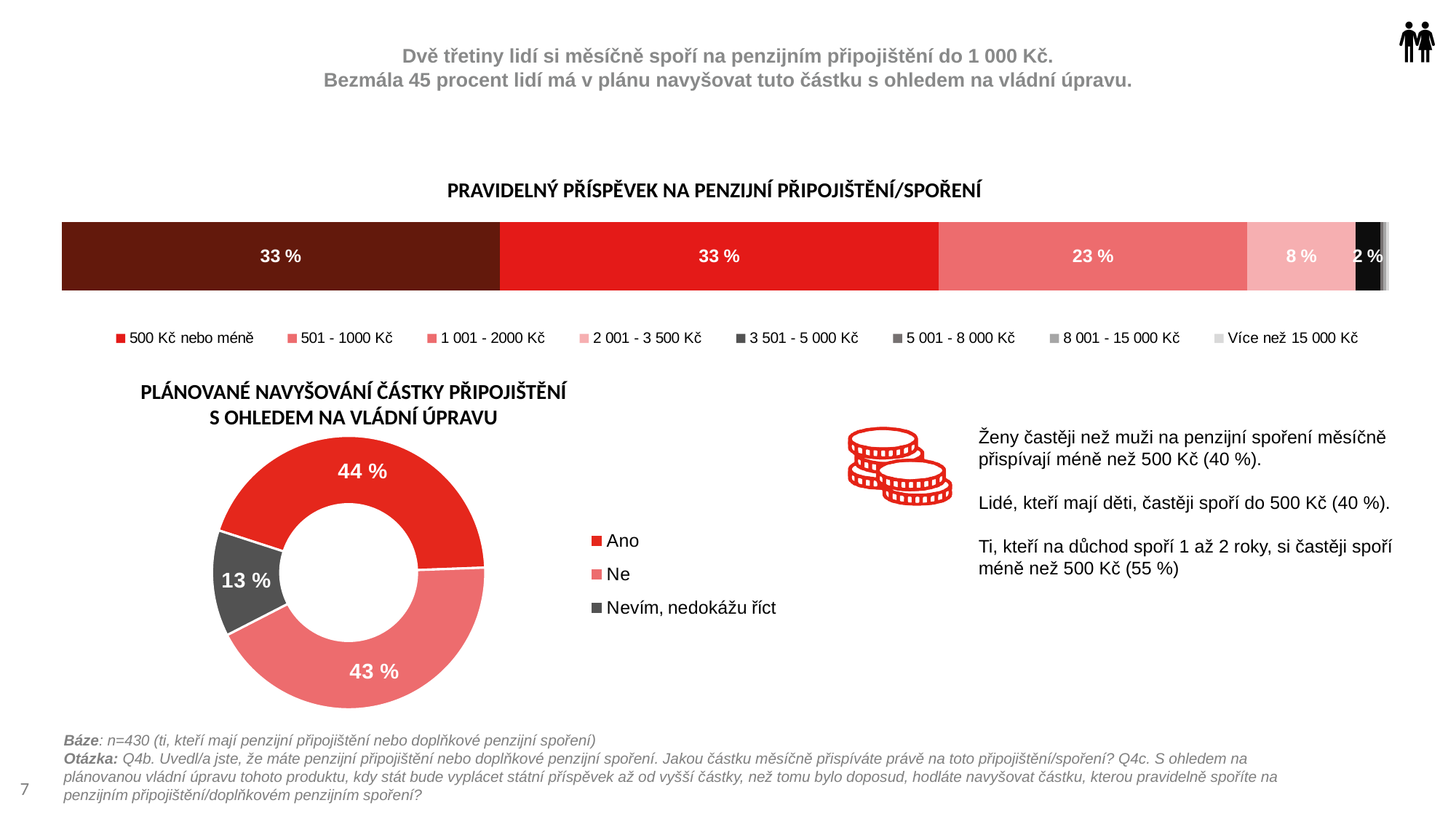
In the chart 'Pravidelný příspěvek na penzijní připojištění/spoření', what is the value for the '2 001 - 3 500 Kč' segment? 8 % In the chart 'Plánované navyšování částky připojištění s ohledem na vládní úpravu', what is the value for 'Nevím, nedokážu říct'? 13 % In the chart 'Pravidelný příspěvek na penzijní připojištění/spoření', how many entries does the legend list? 8 In the chart 'Plánované navyšování částky připojištění s ohledem na vládní úpravu', which category has the lowest value? Nevím, nedokážu říct In the chart 'Pravidelný příspěvek na penzijní připojištění/spoření', what is the difference between the '1 001 - 2000 Kč' segment and the '2 001 - 3 500 Kč' segment? 15 % In the chart 'Plánované navyšování částky připojištění s ohledem na vládní úpravu', what is the value for 'Ano'? 44 % In the chart 'Pravidelný příspěvek na penzijní připojištění/spoření', what is the value for the '501 - 1000 Kč' segment? 33 % What kind of chart is 'Plánované navyšování částky připojištění s ohledem na vládní úpravu'? Donut chart What kind of chart is 'Pravidelný příspěvek na penzijní připojištění/spoření'? Stacked bar chart In the chart 'Pravidelný příspěvek na penzijní připojištění/spoření', which is larger: the '1 001 - 2000 Kč' segment or the '2 001 - 3 500 Kč' segment? 1 001 - 2000 Kč In the chart 'Plánované navyšování částky připojištění s ohledem na vládní úpravu', what is the difference between 'Ne' and 'Nevím, nedokážu říct'? 30 % In the chart 'Pravidelný příspěvek na penzijní připojištění/spoření', what is the value for the '1 001 - 2000 Kč' segment? 23 %